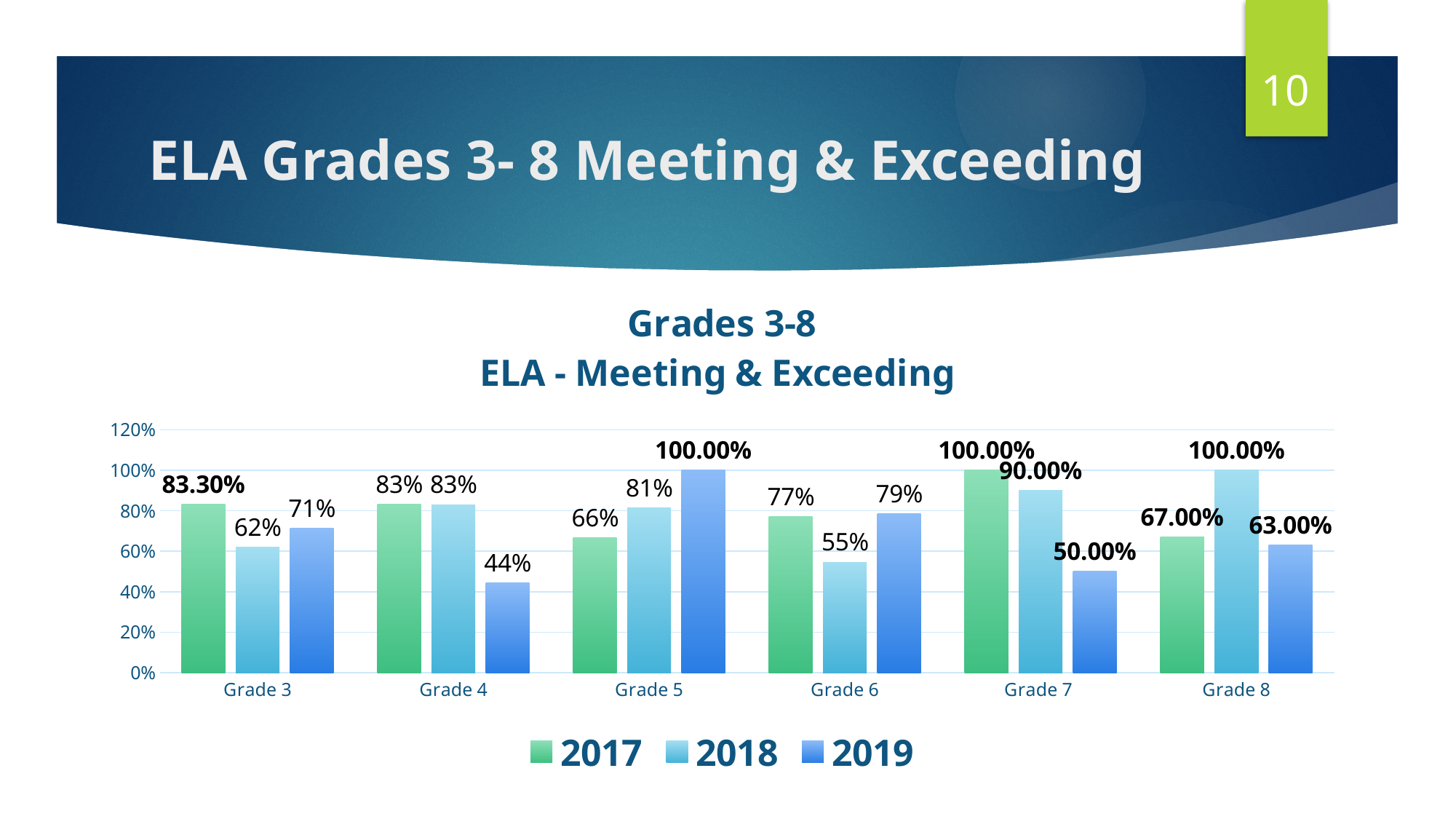
What is the title of the chart? Grades 3-8 ELA - Meeting & Exceeding What kind of chart is shown on the slide? Bar chart How many series does the legend list? 3 How many grades are shown on the x axis? 6 What is the 2018 value for Grade 7? 90.00% Which grade has the lowest 2019 value? Grade 4 What is the 2019 value for Grade 8? 63.00% What is the difference between the 2018 and 2019 values for Grade 7? 40.00% What is the 2017 value for Grade 3? 83.30% What is the 2019 value for Grade 4? 44% Which grade has the highest 2017 value? Grade 7 Which is larger for Grade 6, the 2017 value or the 2019 value? 2019